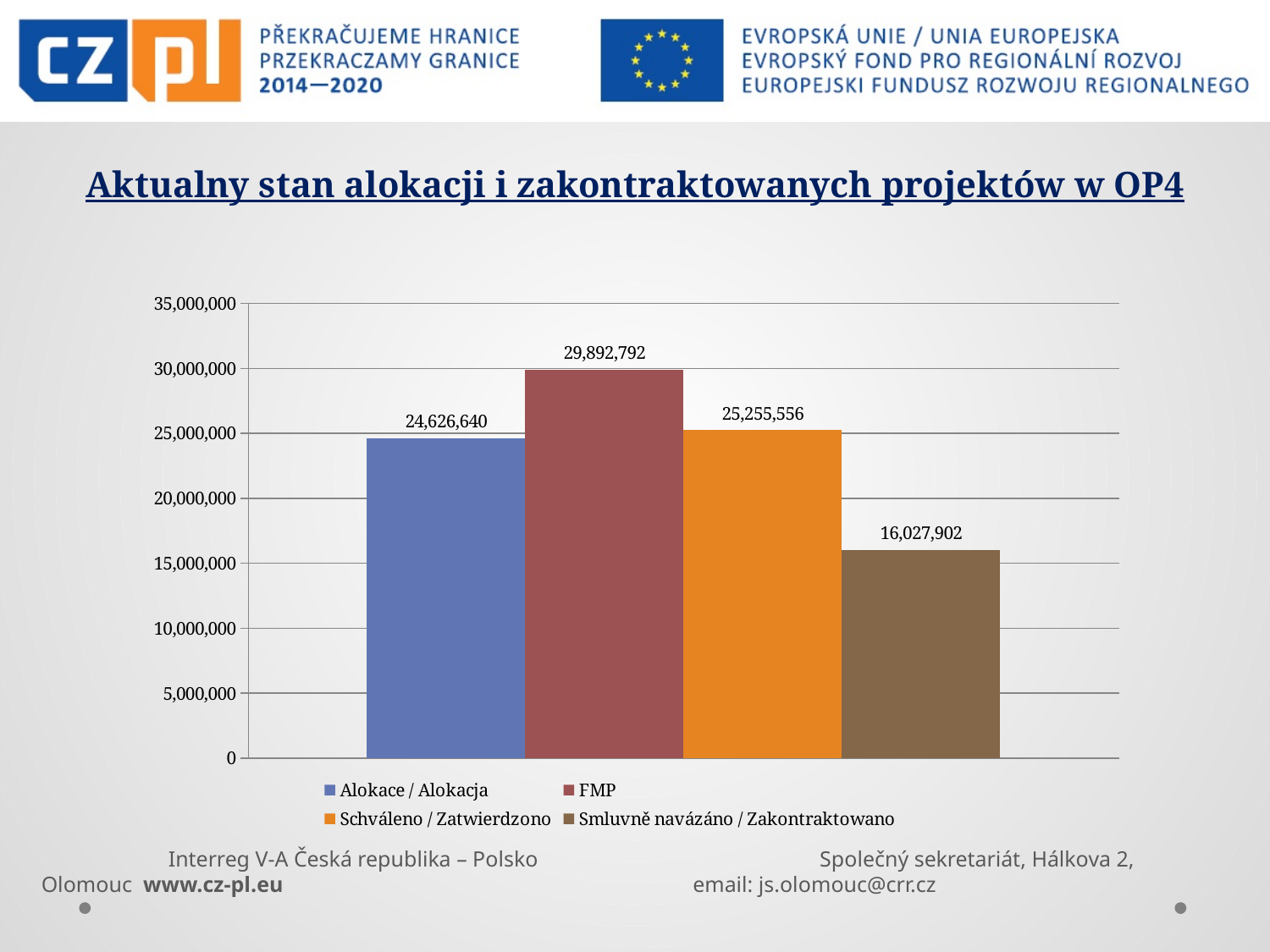
What is the value for Schváleno / Zatwierdzono? 25,255,556 What is the difference between Schváleno / Zatwierdzono and Smluvně navázáno / Zakontraktowano? 9,227,654 What is the value for Alokace / Alokacja? 24,626,640 How many series does the legend list? 4 Which series has the highest value? FMP Which is larger, Schváleno / Zatwierdzono or Alokace / Alokacja? Schváleno / Zatwierdzono What kind of chart is shown on the slide? bar chart What is the difference between the FMP value and the Alokace / Alokacja value? 5,266,152 Is the value for Smluvně navázáno / Zakontraktowano greater or less than 20,000,000? less Which series has the lowest value? Smluvně navázáno / Zakontraktowano What is the value for Smluvně navázáno / Zakontraktowano? 16,027,902 What is the value for FMP? 29,892,792